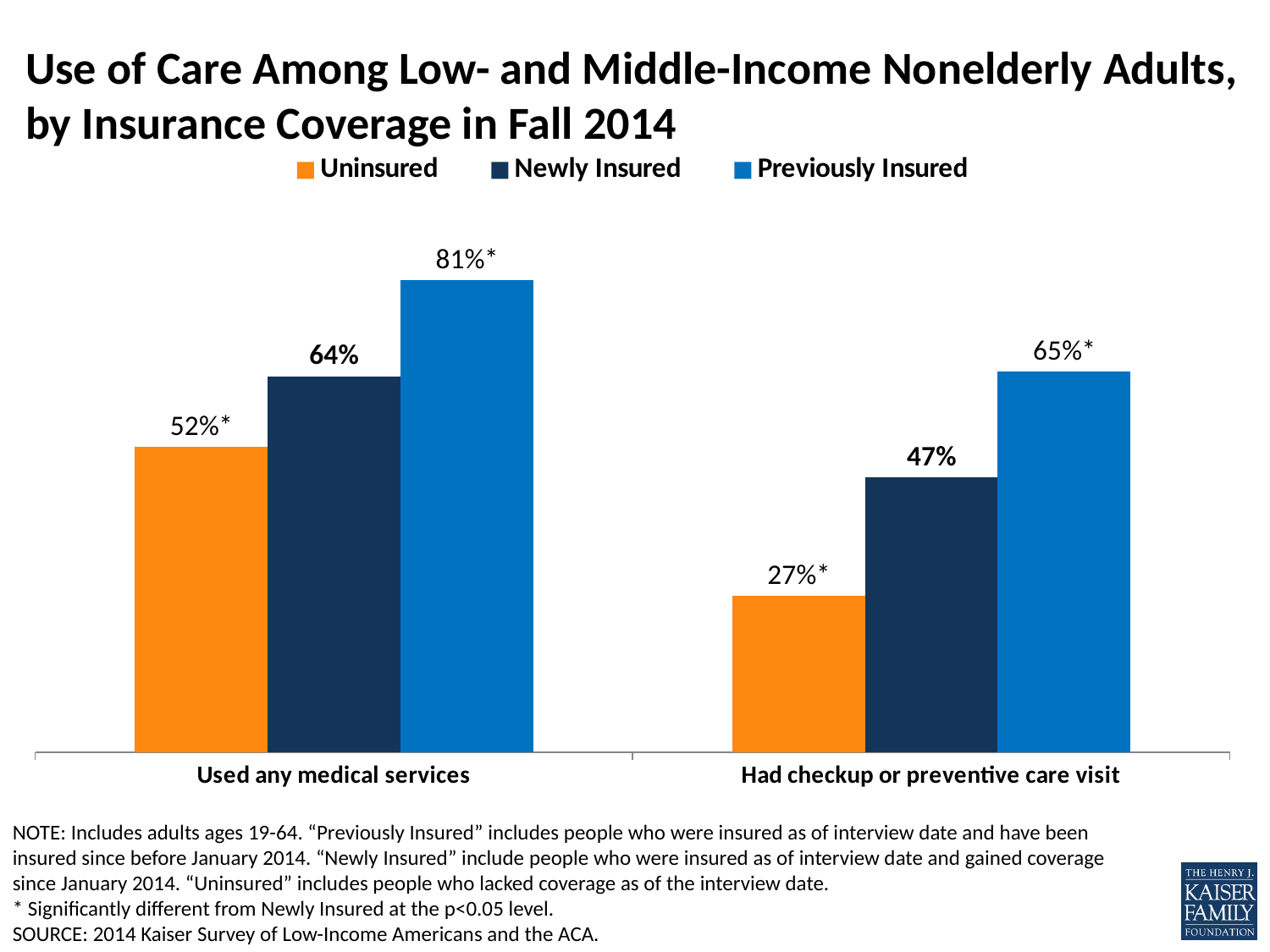
What percentage of Newly Insured adults used any medical services? 64% How many categories are shown on the x axis? 2 How many series does the legend list? 3 What percentage of Uninsured adults used any medical services? 52% Which insurance group has the highest share that used any medical services? Previously Insured What kind of chart is shown on the slide? Bar chart Which insurance group has the lowest share that had a checkup or preventive care visit? Uninsured Which is larger: the Newly Insured share for 'Used any medical services' or the Previously Insured share for 'Had checkup or preventive care visit'? Previously Insured share for 'Had checkup or preventive care visit' What is the difference between the Newly Insured and Uninsured shares for 'Had checkup or preventive care visit'? 20 percentage points What is the difference between the Previously Insured and Uninsured shares for 'Used any medical services'? 29 percentage points Which colour represents the Uninsured series in the legend? Orange What percentage of Previously Insured adults had a checkup or preventive care visit? 65%